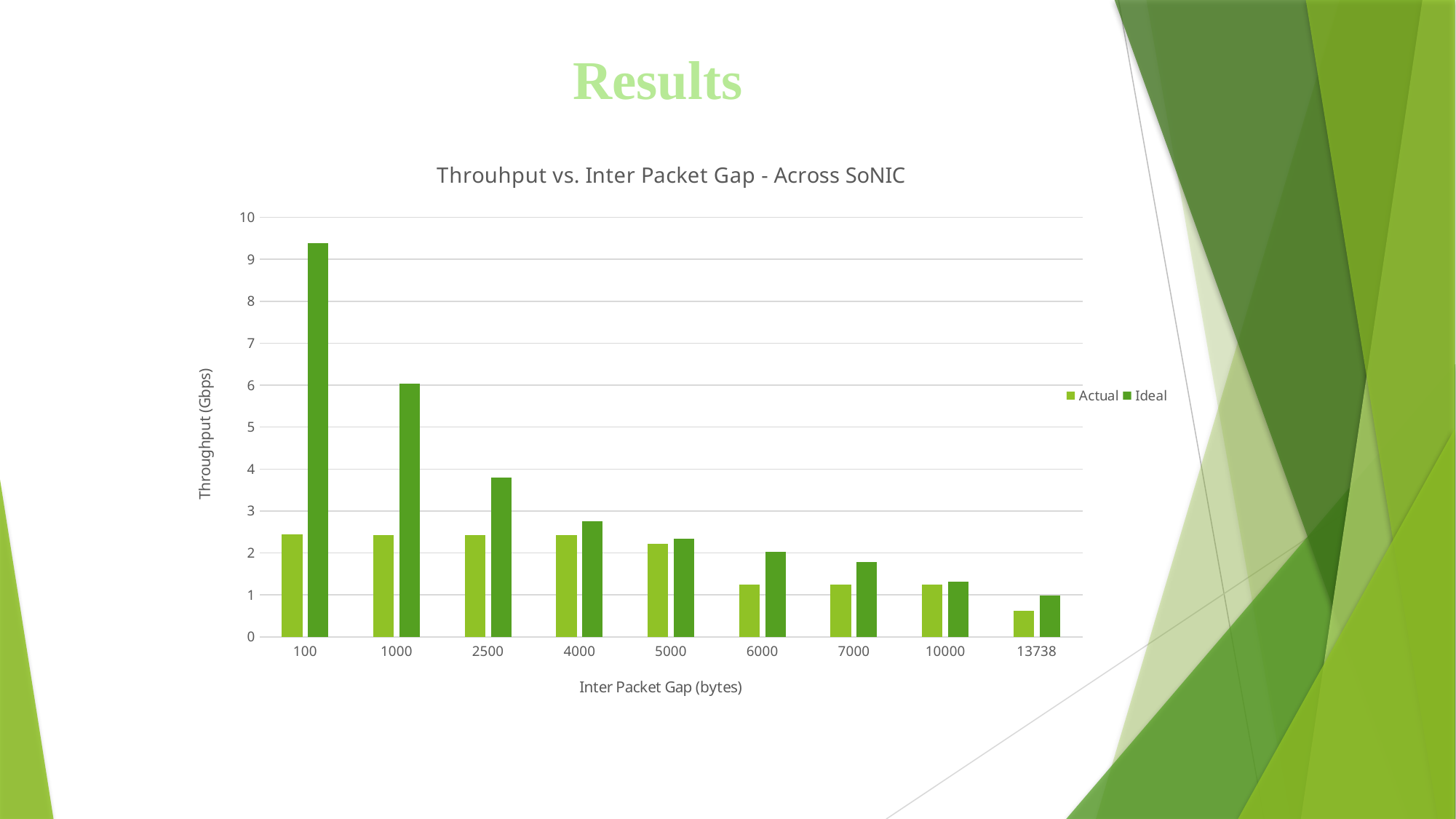
Is the Ideal throughput at an inter packet gap of 2500 greater or less than 3? greater Which inter packet gap has the highest Ideal throughput? 100 Which inter packet gap has the lowest Ideal throughput? 13738 Does the Ideal throughput rise or fall as the inter packet gap increases along the x axis? fall Which inter packet gap has the lowest Actual throughput? 13738 Is the Actual throughput at an inter packet gap of 13738 greater or less than 1? less What kind of chart is shown on the slide? bar chart What is the title of the chart? Throuhput vs. Inter Packet Gap - Across SoNIC Is the Ideal throughput at an inter packet gap of 100 greater or less than 9? greater At an inter packet gap of 100, which is larger, the Actual or the Ideal throughput? Ideal How many series does the legend list? 2 How many inter packet gap categories are shown on the x axis? 9